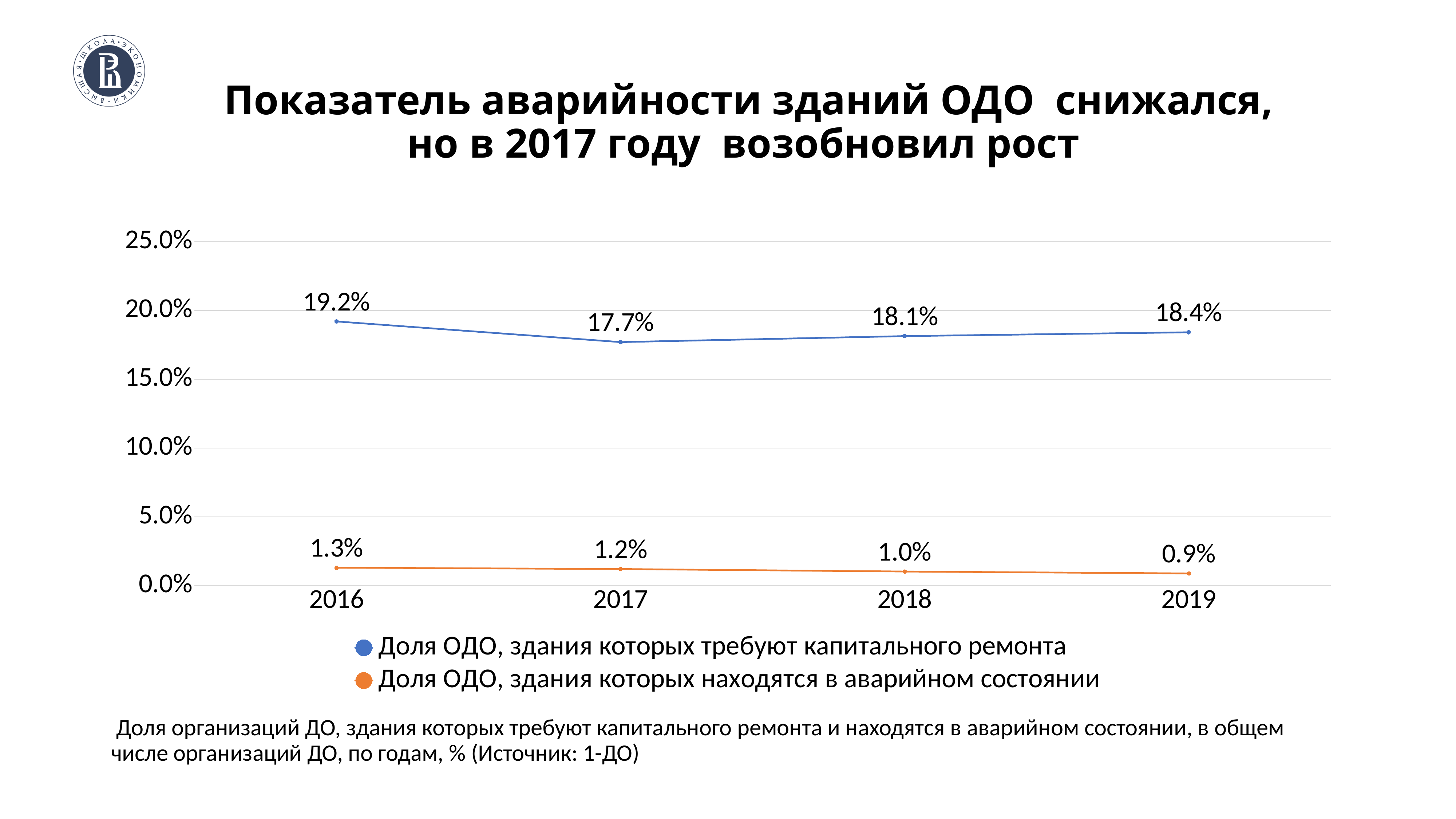
In which year is the series 'Доля ОДО, здания которых требуют капитального ремонта' at its highest? 2016 What kind of chart is shown on the slide? line chart Does the series 'Доля ОДО, здания которых находятся в аварийном состоянии' rise or fall from 2016 to 2019? fall What is the value for 2019 in the series 'Доля ОДО, здания которых находятся в аварийном состоянии'? 0.9% How many years are shown on the x axis? 4 In which year is the series 'Доля ОДО, здания которых требуют капитального ремонта' at its lowest? 2017 What is the value for 2017 in the series 'Доля ОДО, здания которых требуют капитального ремонта'? 17.7% In which year is the series 'Доля ОДО, здания которых находятся в аварийном состоянии' at its highest? 2016 Which is larger for the series 'Доля ОДО, здания которых требуют капитального ремонта': the value for 2018 or the value for 2019? 2019 How many series does the legend list? 2 What is the difference between the 2016 and 2017 values of the series 'Доля ОДО, здания которых требуют капитального ремонта'? 1.5% What is the value for 2016 in the series 'Доля ОДО, здания которых требуют капитального ремонта'? 19.2%